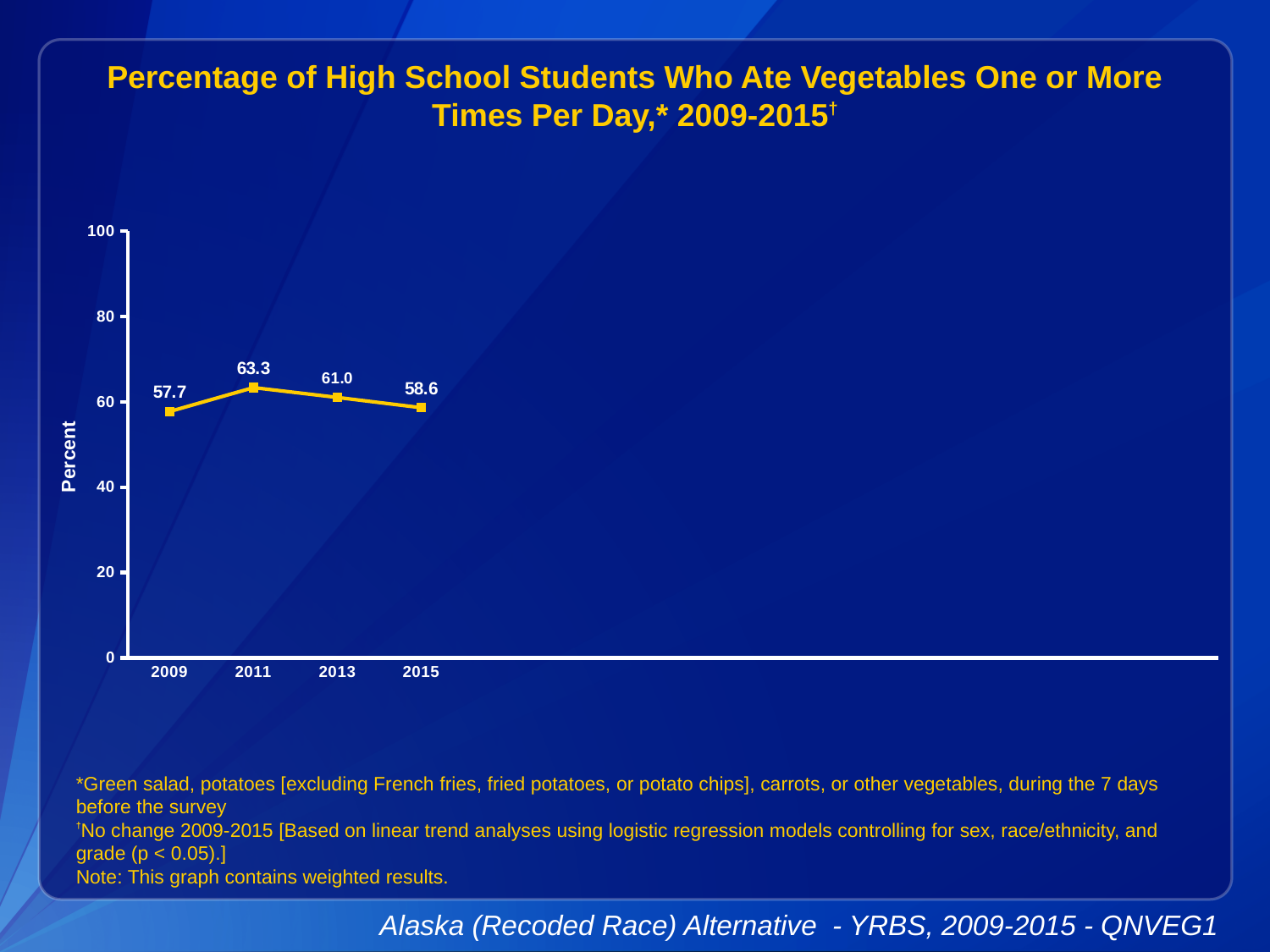
Is the value for 2011 greater or less than 60? greater What is the value plotted for 2015? 58.6 What is the label on the y axis? Percent Which year has the highest percentage? 2011 Which year has the lowest percentage? 2009 What is the value plotted for 2011? 63.3 Which year has the larger value, 2013 or 2015? 2013 What percentage of high school students ate vegetables one or more times per day in 2009? 57.7 What is the value plotted for 2013? 61.0 What kind of chart is shown on the slide? line chart How many years are plotted on the chart? 4 What is the difference between the 2011 value and the 2009 value? 5.6